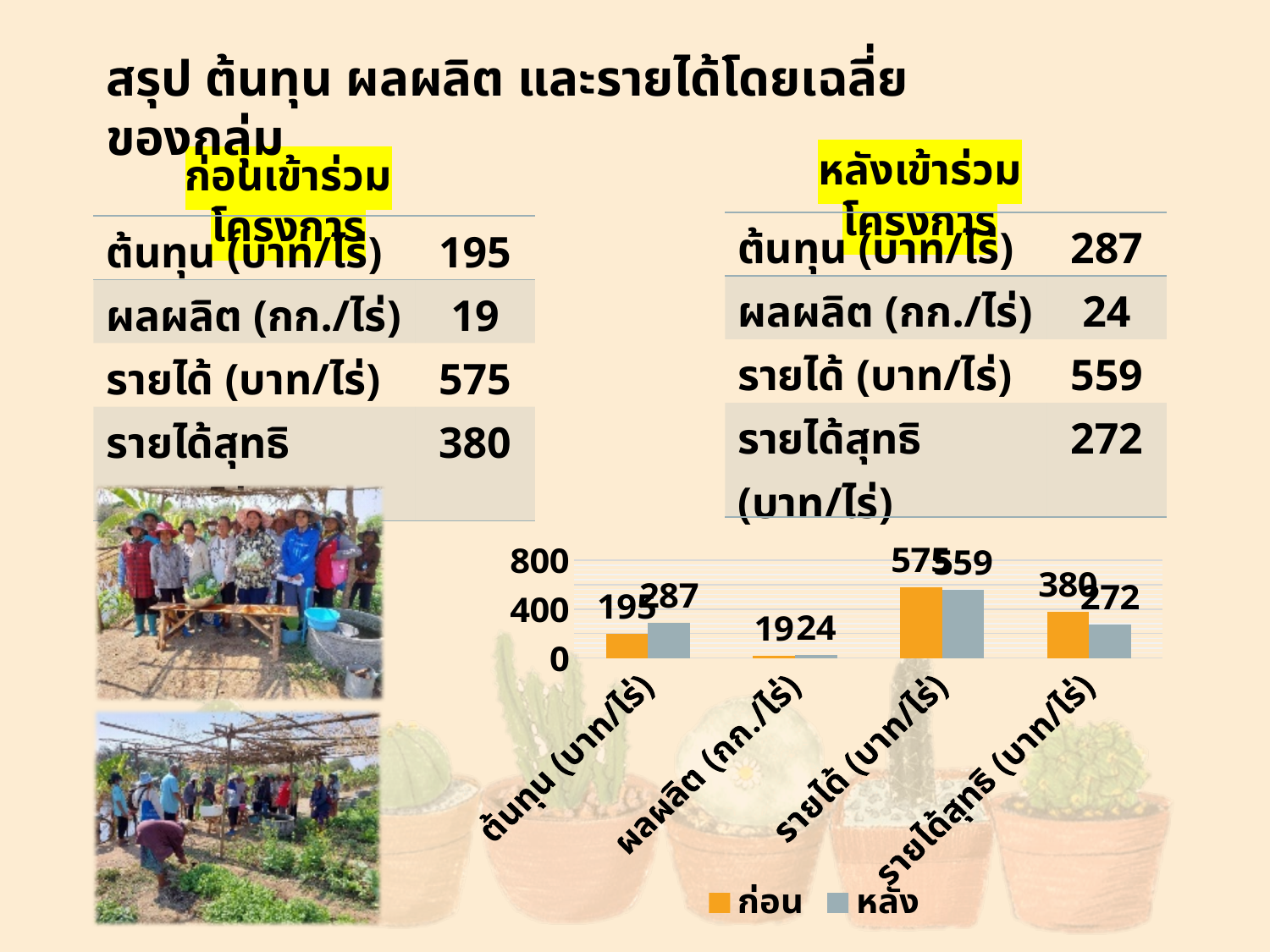
What is the difference between the ก่อน and หลัง values for รายได้สุทธิ (บาท/ไร่)? 108 What kind of chart is shown at the bottom right of the slide? bar chart What is the value of หลัง for ผลผลิต (กก./ไร่) in the chart? 24 How many categories are shown on the x axis of the chart? 4 For ต้นทุน (บาท/ไร่), which is larger: ก่อน or หลัง? หลัง What is the value of ก่อน for ต้นทุน (บาท/ไร่) in the chart? 195 Which category has the highest ก่อน value in the chart? รายได้ (บาท/ไร่) Which colour represents the ก่อน series in the chart? orange What is the value of หลัง for ต้นทุน (บาท/ไร่) in the chart? 287 How many series does the chart legend list? 2 Which category has the lowest หลัง value in the chart? ผลผลิต (กก./ไร่) What is the value of ก่อน for รายได้สุทธิ (บาท/ไร่) in the chart? 380